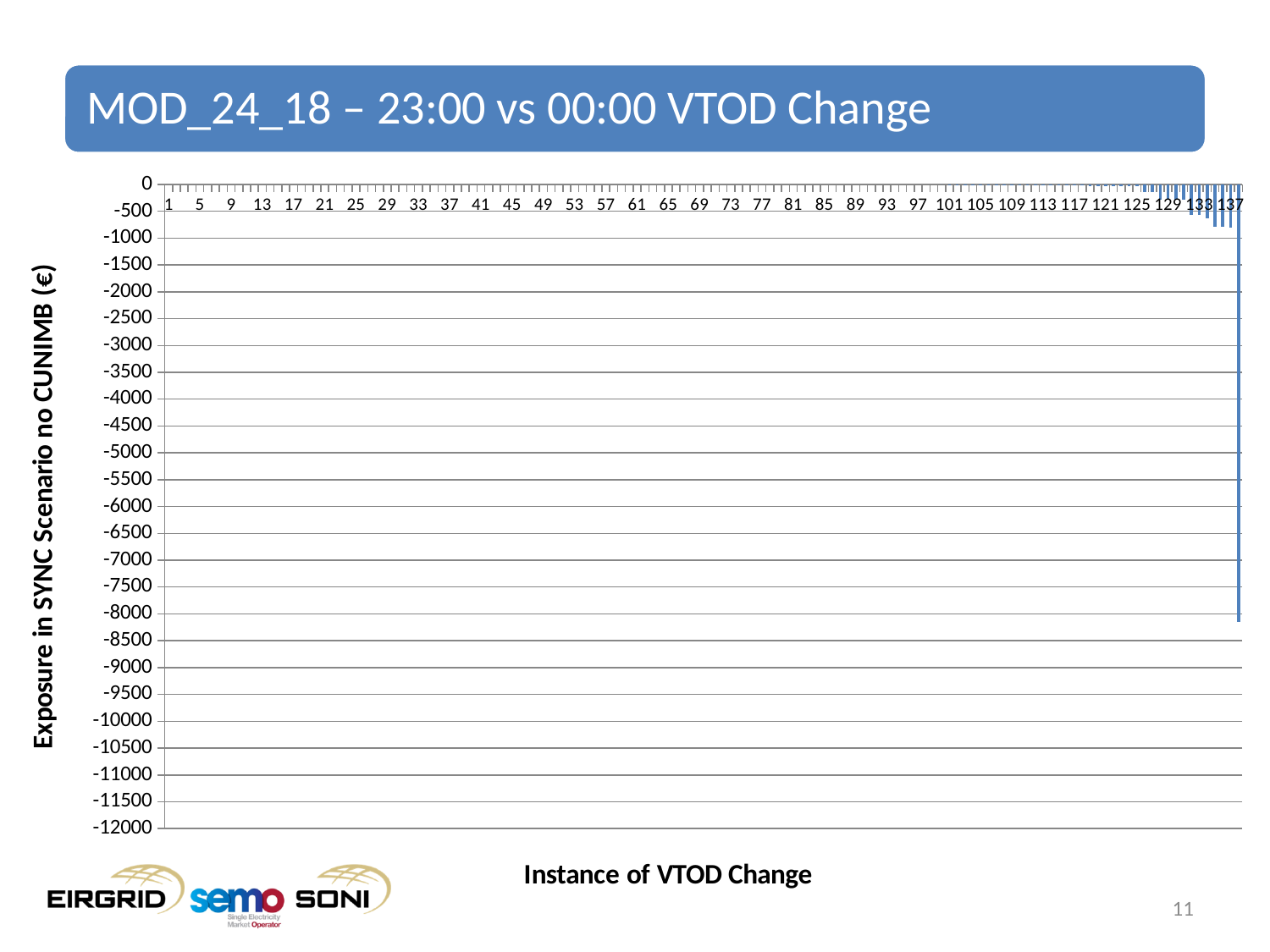
Do the exposure values rise or fall as you move from left to right along the x axis? fall What kind of chart is shown on the slide? bar chart Which has the lower (more negative) value: instance 1 or the rightmost instance? the rightmost instance Is the value for the rightmost (last) instance of VTOD change greater or less than -10000? greater Is the value for instance 65 greater or less than -1000? greater Is the value for the rightmost (last) instance of VTOD change greater or less than -5000? less What is the title of the chart on the slide? MOD_24_18 – 23:00 vs 00:00 VTOD Change What is the label of the vertical axis of the chart? Exposure in SYNC Scenario no CUNIMB (€) Which instance has the lowest (most negative) exposure value? the last (rightmost) instance